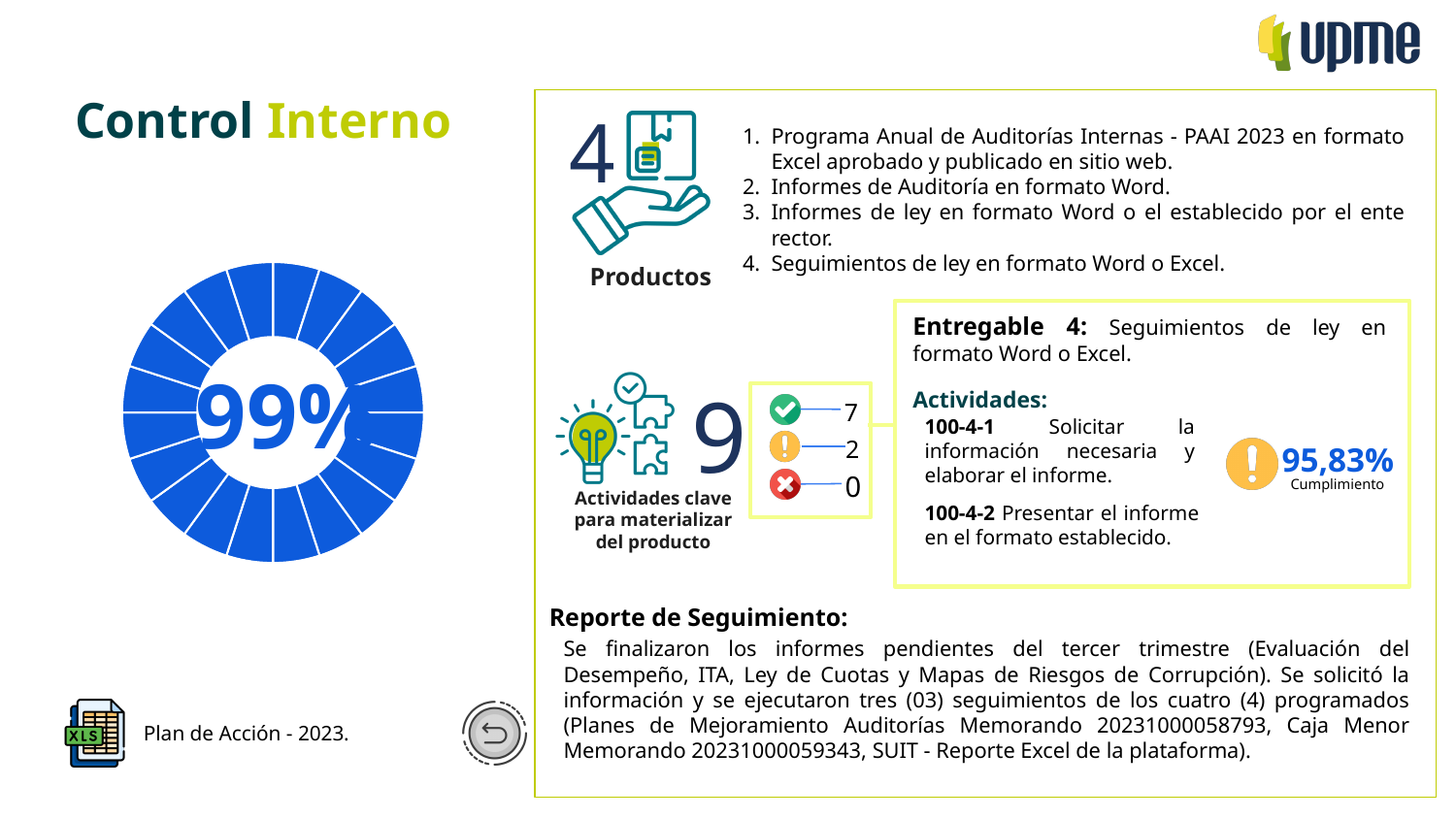
What colour are the segments of the donut chart on the left of the slide? Blue In the status indicator next to "Actividades clave para materializar del producto", which status icon has the highest count? Green check In the status indicator next to "Actividades clave para materializar del producto", what number is shown beside the green check icon? 7 In the status indicator next to "Actividades clave para materializar del producto", what is the difference between the green check count and the orange warning count? 5 What percentage of "Cumplimiento" is shown next to the Entregable 4 activities? 95,83% In the status indicator next to "Actividades clave para materializar del producto", what number is shown beside the red X icon? 0 In the status indicator next to "Actividades clave para materializar del producto", what number is shown beside the orange warning icon? 2 What kind of chart is shown on the left side of the slide under the heading "Control Interno"? Donut chart Is the value shown in the donut chart greater or less than 50%? greater In the status indicator next to "Actividades clave para materializar del producto", how many status categories are shown? 3 What percentage is shown in the centre of the donut chart on the left of the slide? 99% What heading appears above the donut chart on the left of the slide? Control Interno